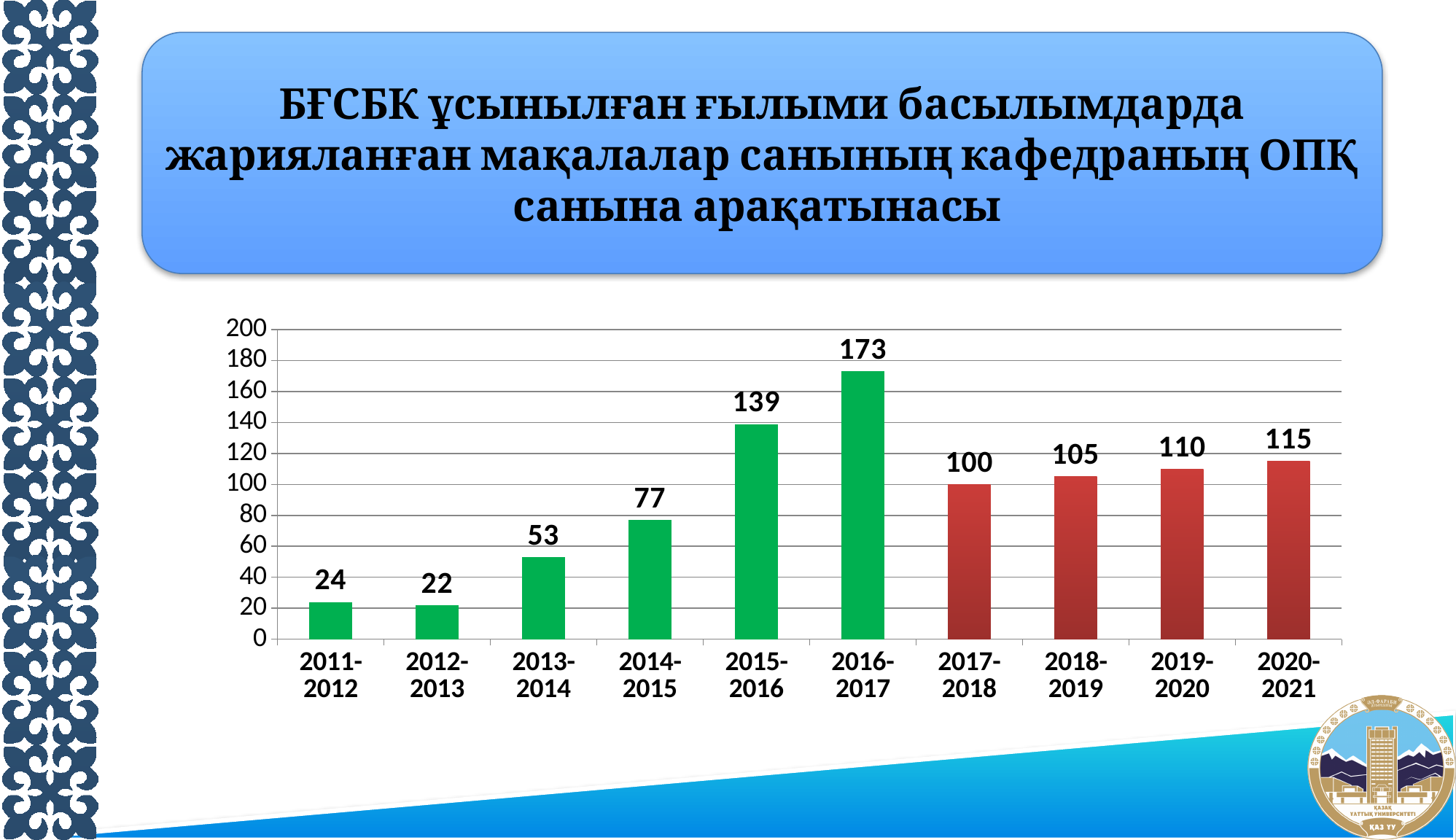
What is the difference between the values for 2016-2017 and 2015-2016? 34 What is the value for 2020-2021? 115 Which year range has the lowest value? 2012-2013 Is the value for 2015-2016 greater or less than 120? greater Which is larger, the value for 2014-2015 or the value for 2017-2018? 2017-2018 What kind of chart is shown on the slide? bar chart What is the difference between the values for 2020-2021 and 2017-2018? 15 What colour are the bars for 2017-2018 through 2020-2021? red What is the value for 2013-2014? 53 What is the value for 2016-2017? 173 Which year range has the highest value? 2016-2017 How many year ranges are shown on the x axis? 10